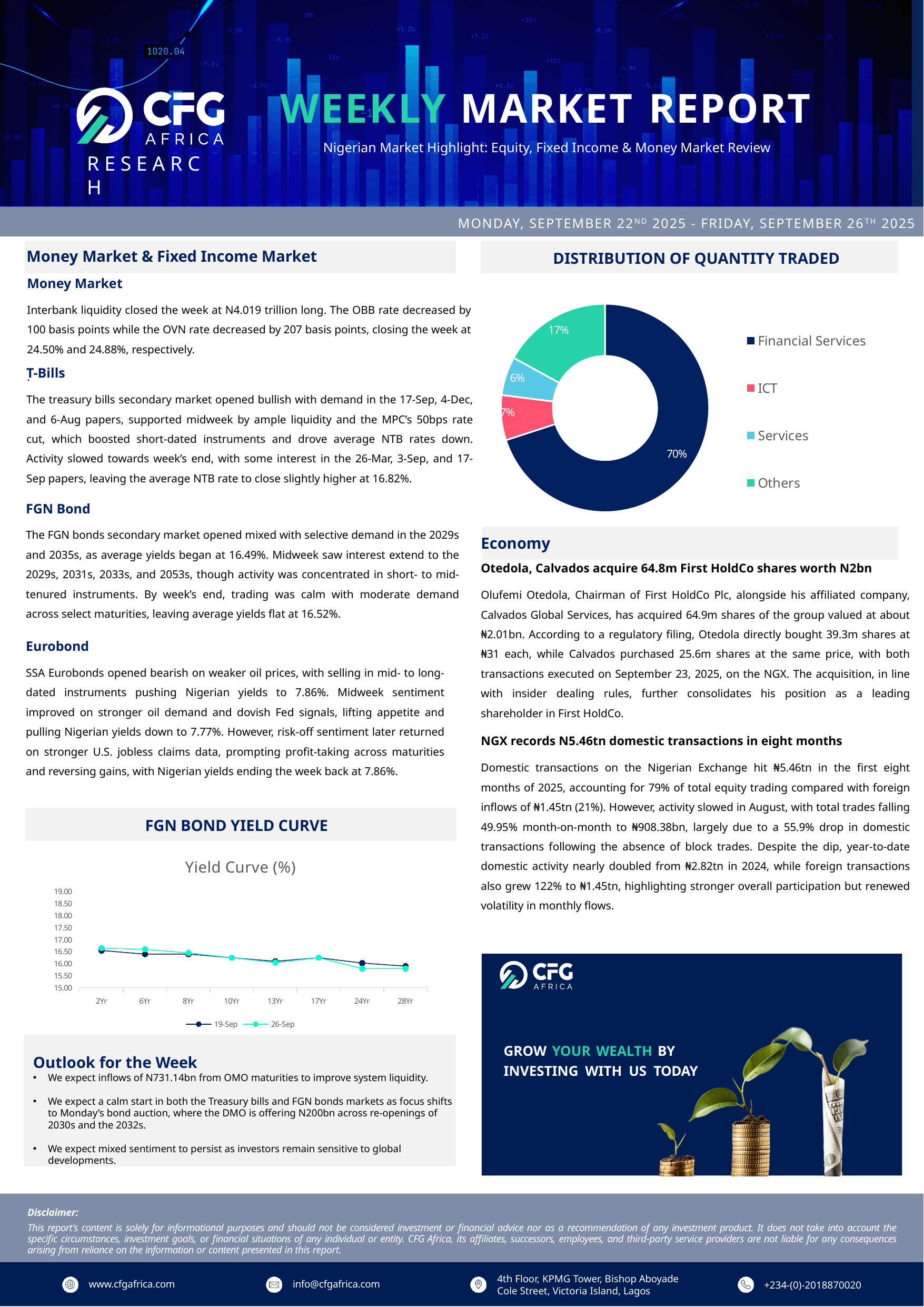
In the DISTRIBUTION OF QUANTITY TRADED chart, which sector has the largest share? Financial Services What type of chart is the DISTRIBUTION OF QUANTITY TRADED chart? Doughnut (pie) chart In the FGN BOND YIELD CURVE chart, is the 26-Sep value for 2Yr greater or less than 16.00? greater In the DISTRIBUTION OF QUANTITY TRADED chart, what share does Financial Services account for? 70% In the FGN BOND YIELD CURVE chart, do yields generally rise or fall from 2Yr to 28Yr? Fall In the DISTRIBUTION OF QUANTITY TRADED chart, what is the difference in percentage points between Financial Services and Others? 53 percentage points How many sectors are shown in the DISTRIBUTION OF QUANTITY TRADED chart? 4 In the DISTRIBUTION OF QUANTITY TRADED chart, which sector has the smallest share? Services In the DISTRIBUTION OF QUANTITY TRADED chart, what share is attributed to Others? 17% How many series does the legend of the FGN BOND YIELD CURVE chart list? 2 In the DISTRIBUTION OF QUANTITY TRADED chart, which has the larger share, ICT or Services? ICT How many tenors are plotted on the x axis of the FGN BOND YIELD CURVE chart? 8